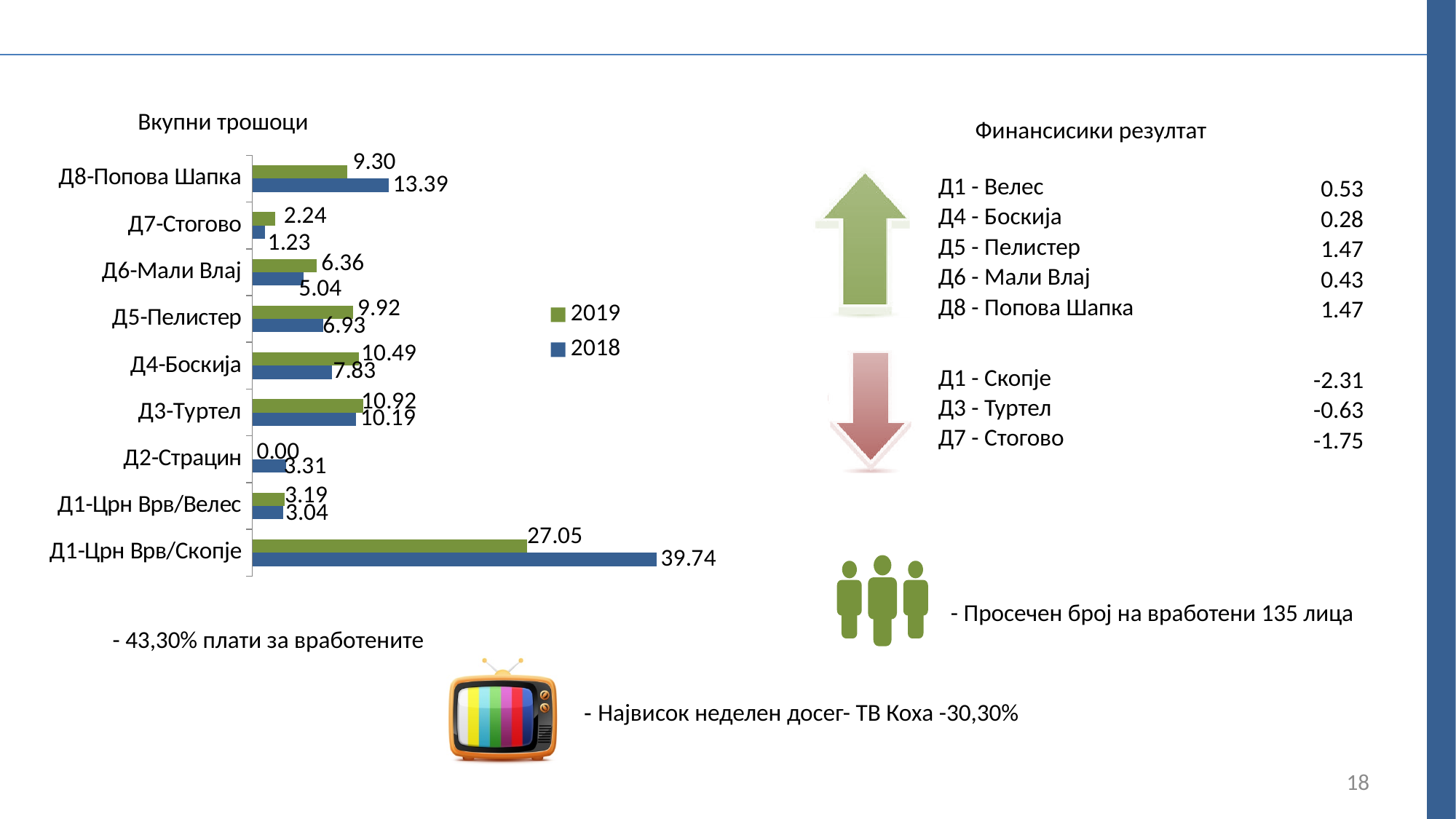
Which category has the highest 2018 value in the Вкупни трошоци chart? Д1-Црн Врв/Скопје What is the 2019 value for Д5-Пелистер in the Вкупни трошоци chart? 9.92 What is the 2018 value for Д8-Попова Шапка in the Вкупни трошоци chart? 13.39 How many categories are shown in the Вкупни трошоци chart? 9 What is the difference between the 2018 and 2019 values for Д1-Црн Врв/Скопје in the Вкупни трошоци chart? 12.69 What is the 2019 value for Д2-Страцин in the Вкупни трошоци chart? 0.00 What type of chart is the Вкупни трошоци chart? bar chart In the Вкупни трошоци chart, which is larger for Д8-Попова Шапка: the 2019 value or the 2018 value? 2018 What is the difference between the 2019 and 2018 values for Д4-Боскија in the Вкупни трошоци chart? 2.66 How many series does the legend of the Вкупни трошоци chart list? 2 In the Вкупни трошоци chart, is the 2019 value for Д7-Стогово larger or smaller than its 2018 value? larger Which category has the lowest 2018 value in the Вкупни трошоци chart? Д7-Стогово